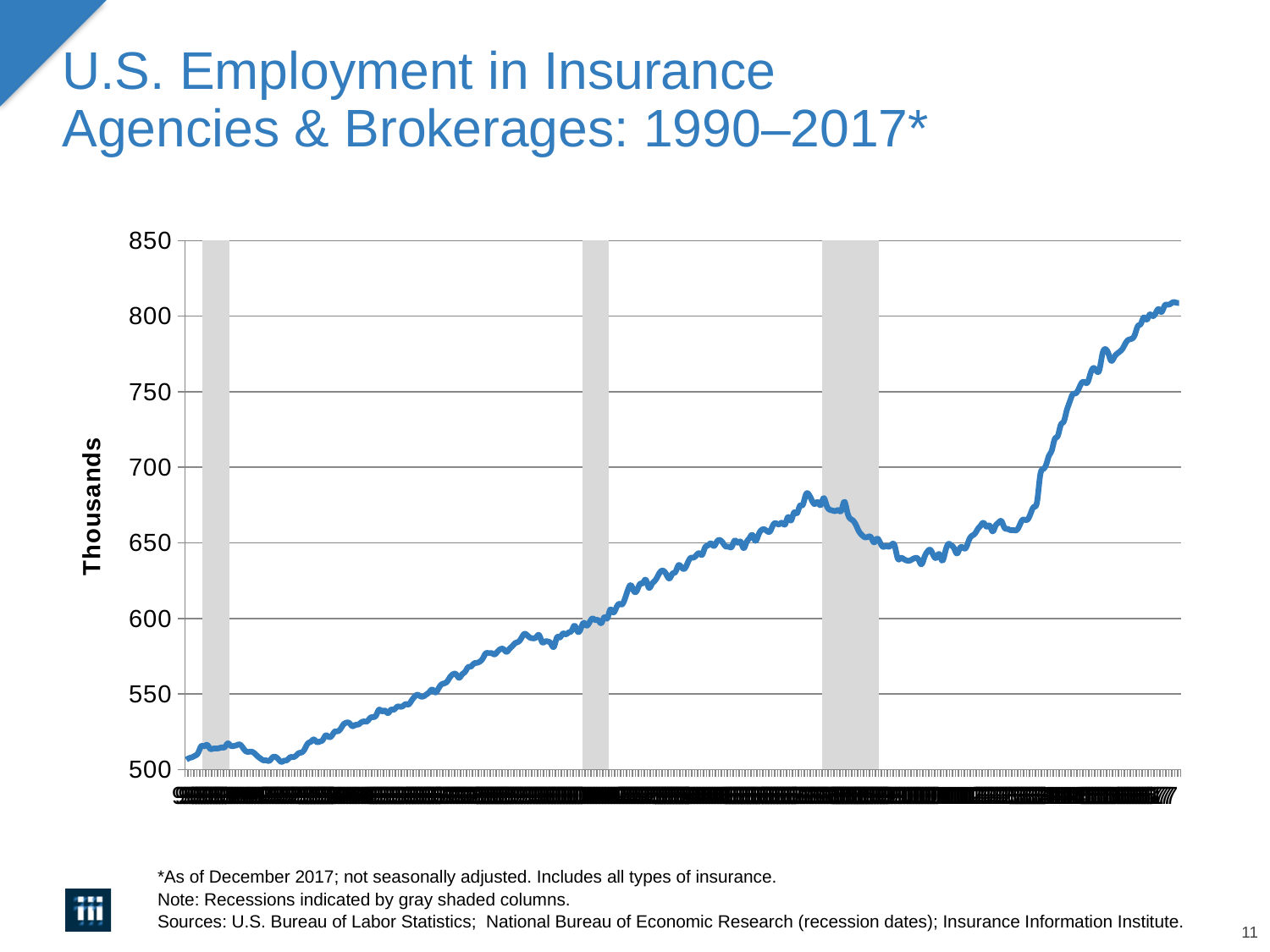
Is the lowest point of the line after the third gray shaded column greater or less than 600? greater Does the line rise or fall across the third gray shaded column? fall What kind of chart is shown on the slide? line chart Overall, do the values rise or fall from the left end of the chart to the right end? rise What is the highest value shown on the vertical axis? 850 Is the value at the right end of the line higher or lower than the value at the left end? higher Is the value at the start of the line (left end) greater or less than 550? less Is the peak reached just before the third gray shaded column greater or less than 650? greater What is the title of the chart? U.S. Employment in Insurance Agencies & Brokerages: 1990–2017* What is the label on the vertical axis of the chart? Thousands